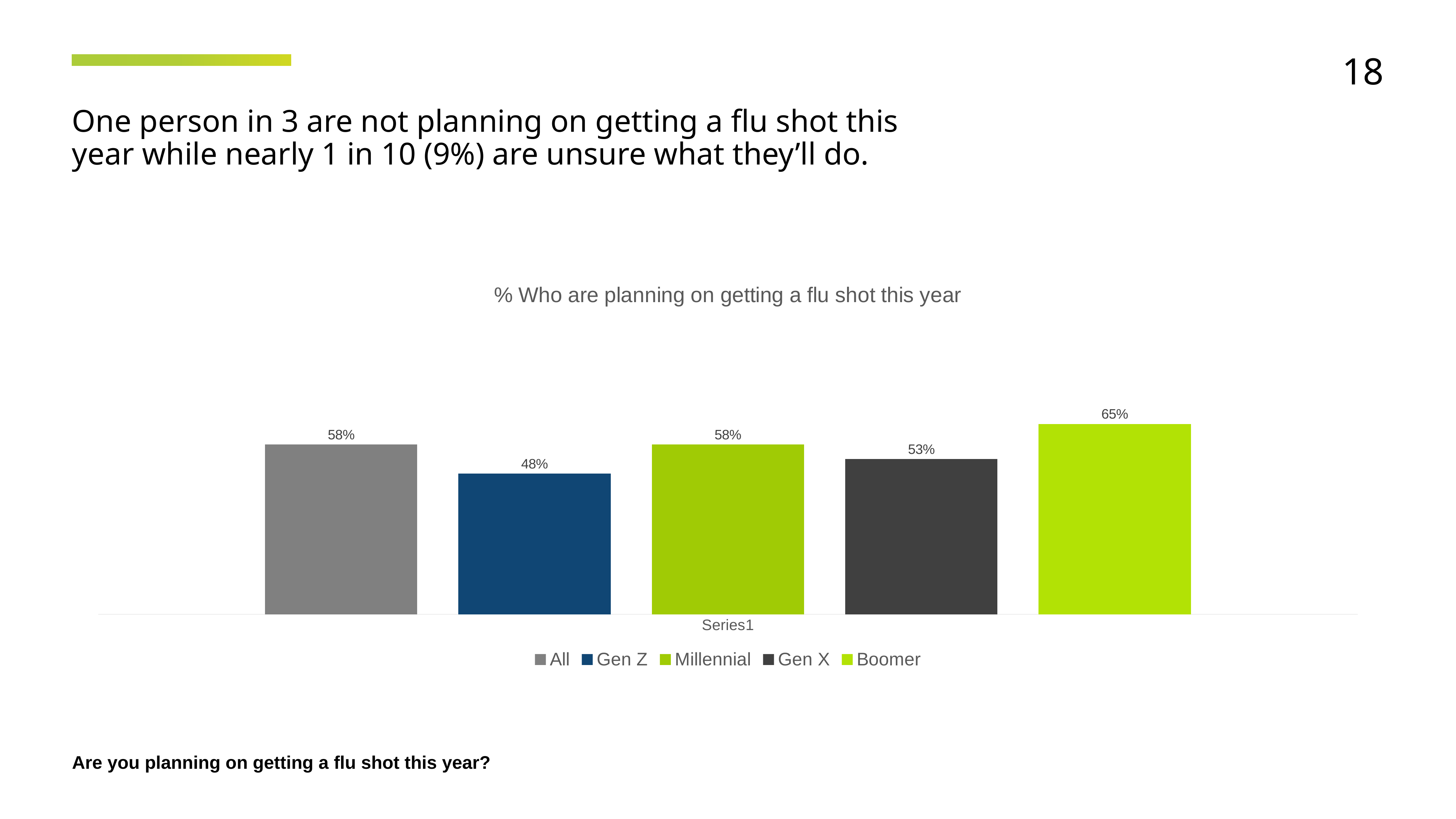
What is the difference between the Millennial value and the Gen X value? 5% What is the value shown for Boomer in the chart? 65% What kind of chart is shown on the slide? Bar chart Which is larger, the value for Gen X or the value for Millennial? Millennial What is the value shown for Gen X in the chart? 53% Which group has the highest percentage planning on getting a flu shot this year? Boomer What percentage of Gen Z are planning on getting a flu shot this year? 48% How many series does the legend list? 5 Which group has the lowest percentage planning on getting a flu shot this year? Gen Z What is the title of the chart? % Who are planning on getting a flu shot this year What is the value shown for All in the chart? 58% What is the difference between the Boomer value and the Gen Z value? 17%